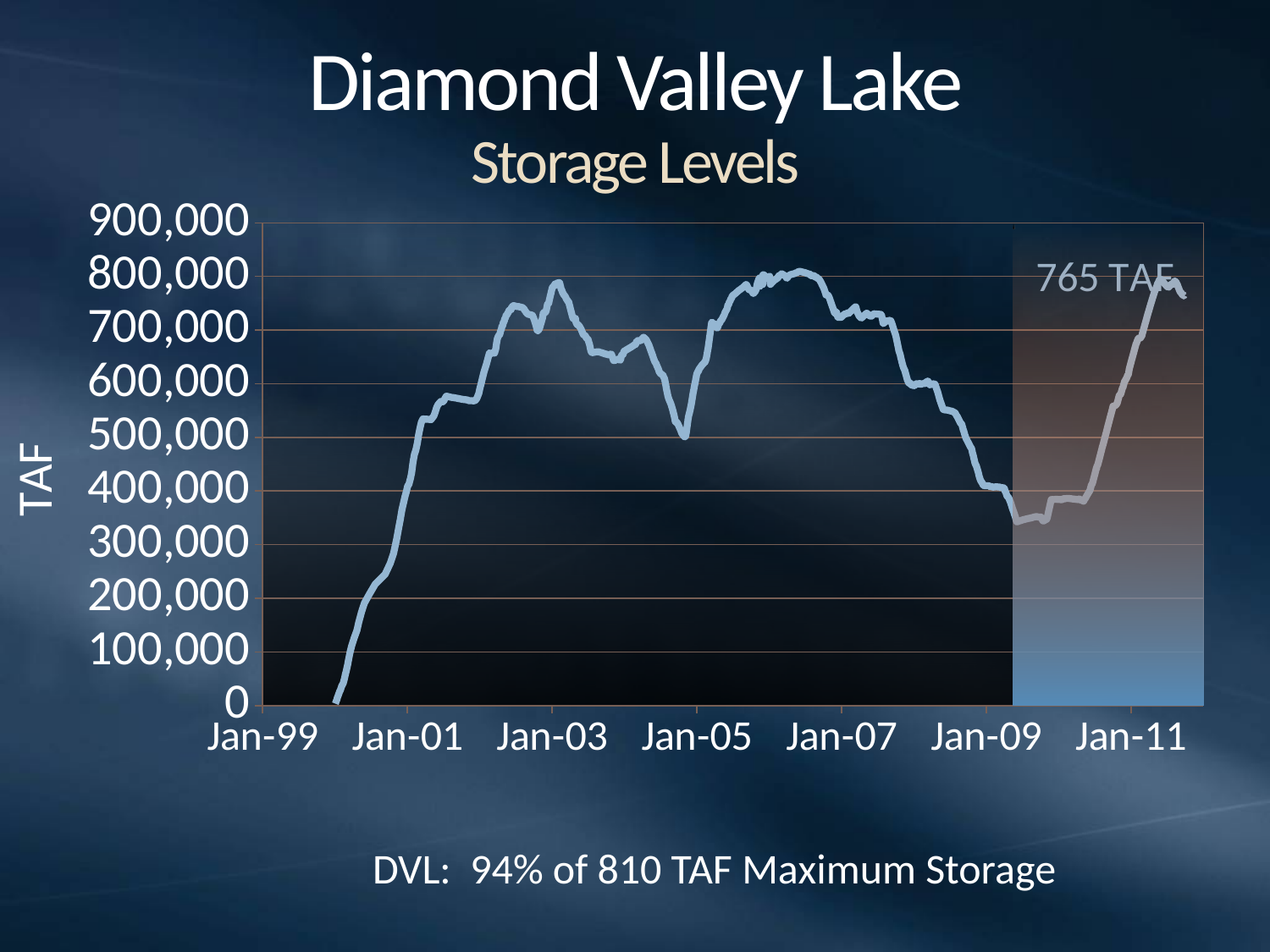
What is the title of the chart on the slide? Diamond Valley Lake Storage Levels Which is larger, the storage level at Jan-07 or at Jan-09? Jan-07 How many date labels are shown along the horizontal axis? 7 Does the storage level rise or fall between Jan-07 and Jan-09? fall Does the storage level rise or fall between Jan-09 and Jan-11? rise What kind of chart is shown on the slide? line chart Is the lowest storage level reached in 2009 greater or less than 400,000? less What storage value is annotated at the end of the line in the shaded region? 765 TAF What label is shown on the vertical axis of the chart? TAF What is the highest value shown on the vertical axis? 900,000 Which is larger, the storage level at Jan-05 or at Jan-07? Jan-07